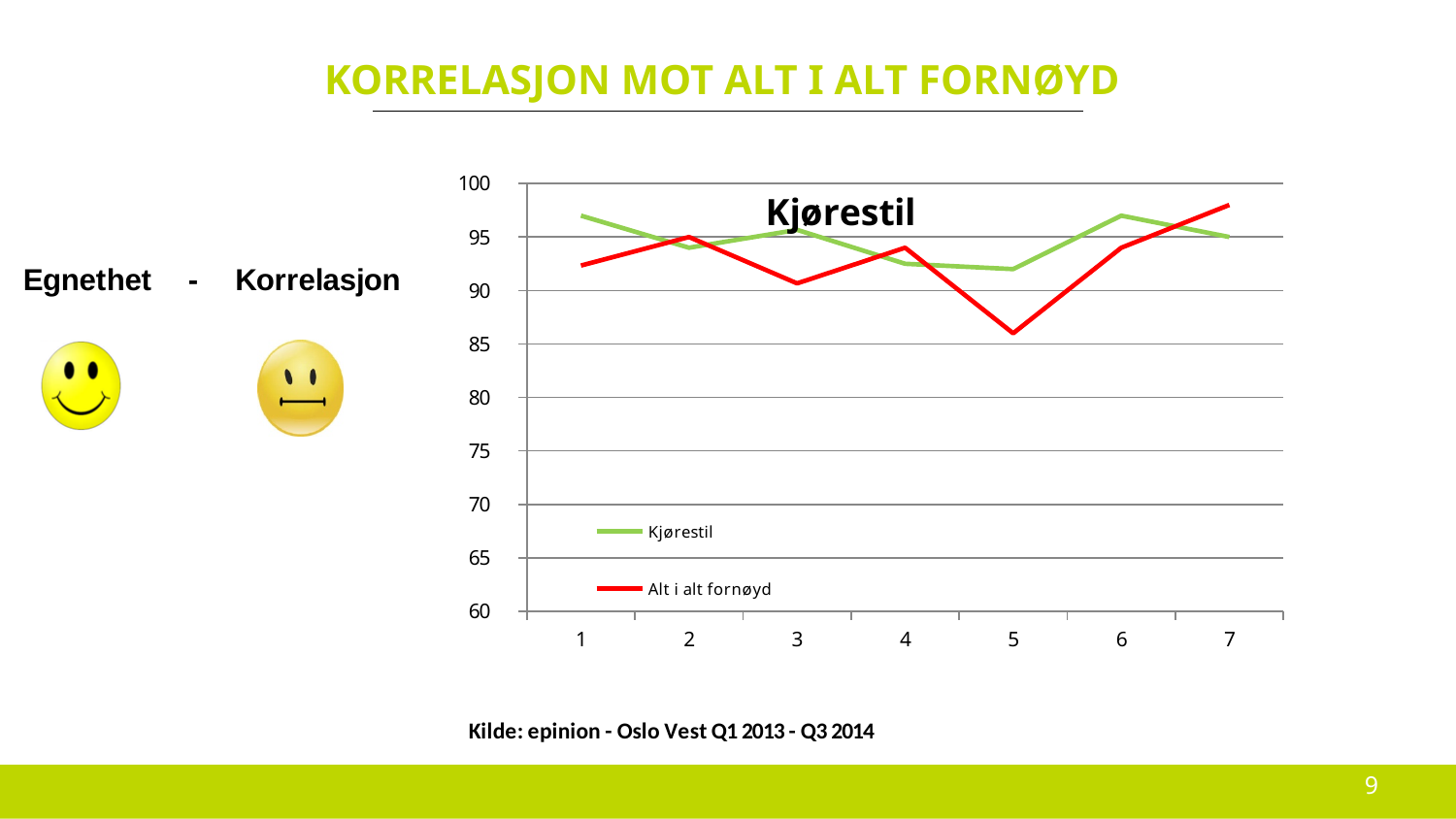
Which series is drawn with the red line? Alt i alt fornøyd Is the value for Kjørestil at point 1 greater or less than 95? greater What kind of chart is shown on the slide? line chart At which x-axis point is the Alt i alt fornøyd series lowest? 5 Is the value for Alt i alt fornøyd at point 7 greater or less than 95? greater Does the Alt i alt fornøyd series rise or fall from point 5 to point 7? rise How many points are plotted along the x axis for each series? 7 At which x-axis point is the Alt i alt fornøyd series highest? 7 At point 5, which series has the higher value, Kjørestil or Alt i alt fornøyd? Kjørestil Is the value for Alt i alt fornøyd at point 5 greater or less than 90? less What is the title of the chart? Kjørestil How many series does the chart legend list? 2